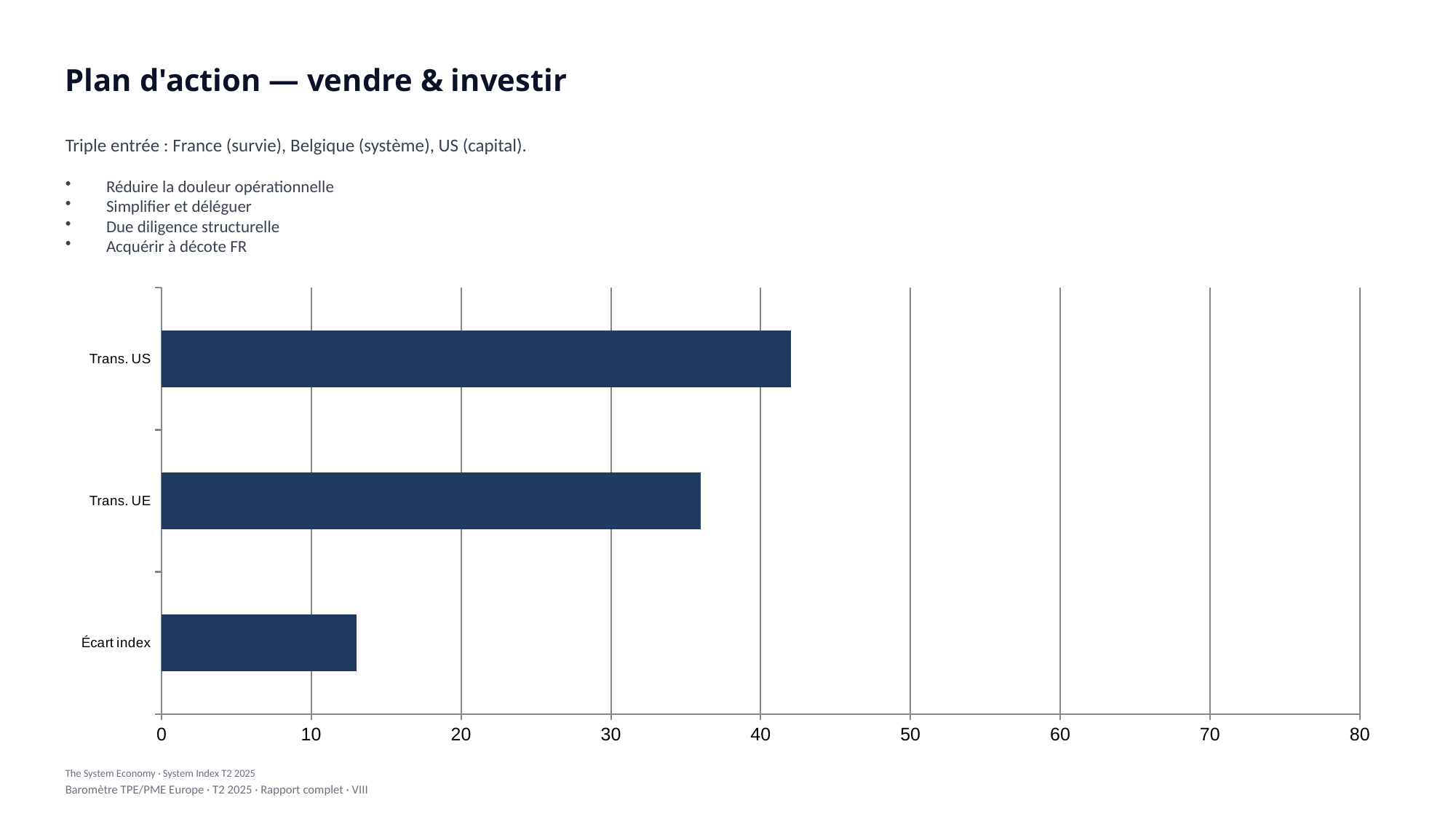
How many categories are plotted in the chart? 3 Which is larger, the value for Trans. US or the value for Trans. UE? Trans. US What kind of chart is shown on the slide? bar chart Is the value for Trans. UE greater or less than 40? less What is the maximum value shown on the horizontal axis of the chart? 80 Is the value for Trans. US greater or less than 40? greater Which category has the lowest value in the chart? Écart index Which category has the highest value in the chart? Trans. US Which is larger, the value for Trans. UE or the value for Écart index? Trans. UE Is the value for Écart index greater or less than 20? less